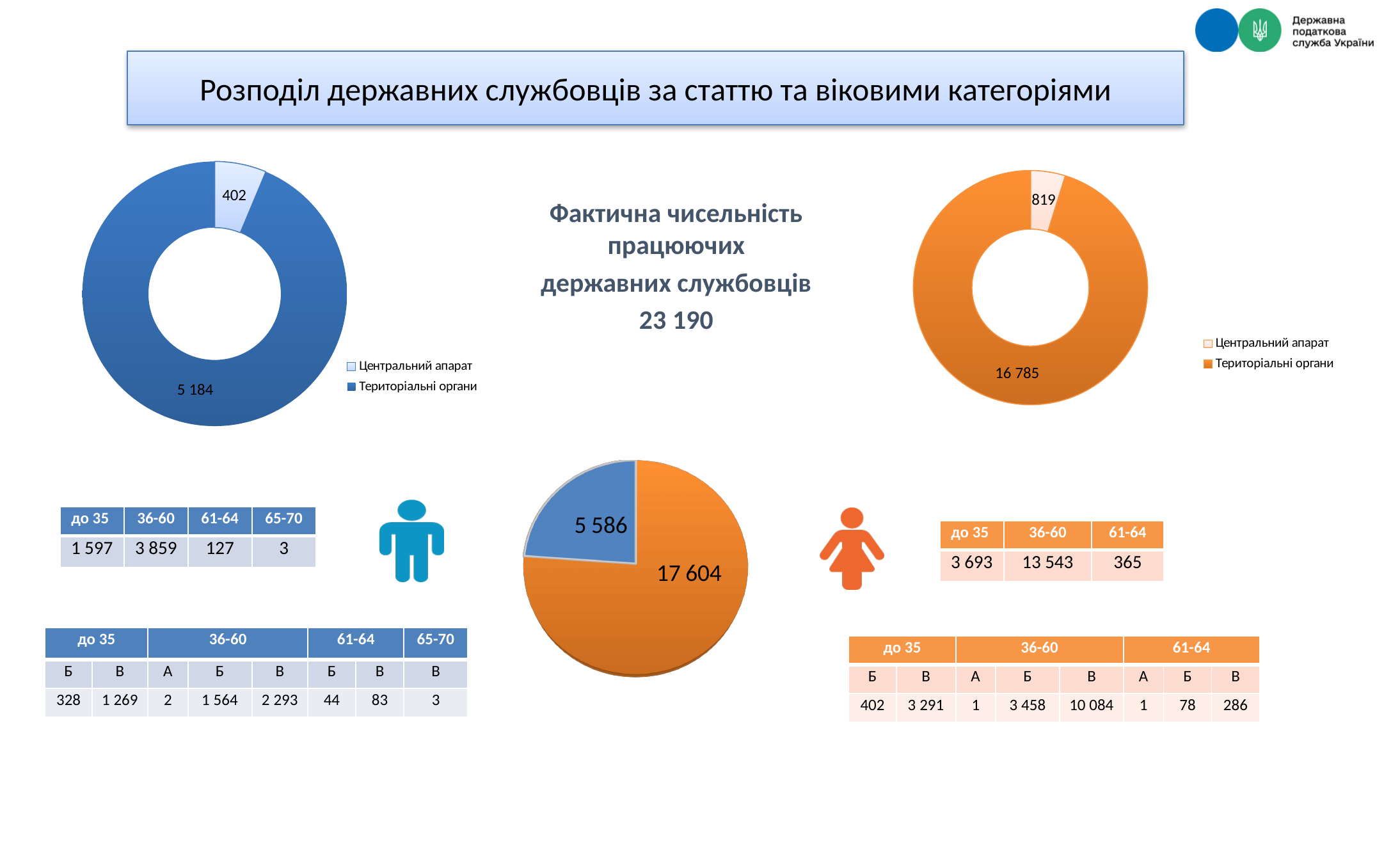
In the pie chart in the centre of the slide, what is the value of the orange slice? 17 604 In the orange doughnut chart on the right, what is the total of the two segments? 17 604 In the blue doughnut chart on the left, what is the difference between Територіальні органи and Центральний апарат? 4 782 In the orange doughnut chart on the right, what is the value for Територіальні органи? 16 785 How many entries does the legend of the orange doughnut chart on the right list? 2 In the blue doughnut chart on the left, what is the value for Територіальні органи? 5 184 In the blue doughnut chart on the left, what is the value for Центральний апарат? 402 In the pie chart in the centre of the slide, what is the value of the blue slice? 5 586 In the blue doughnut chart on the left, which category has the larger value? Територіальні органи In the orange doughnut chart on the right, what is the value for Центральний апарат? 819 In the orange doughnut chart on the right, which category has the smaller value? Центральний апарат In the pie chart in the centre of the slide, what is the difference between the orange slice and the blue slice? 12 018